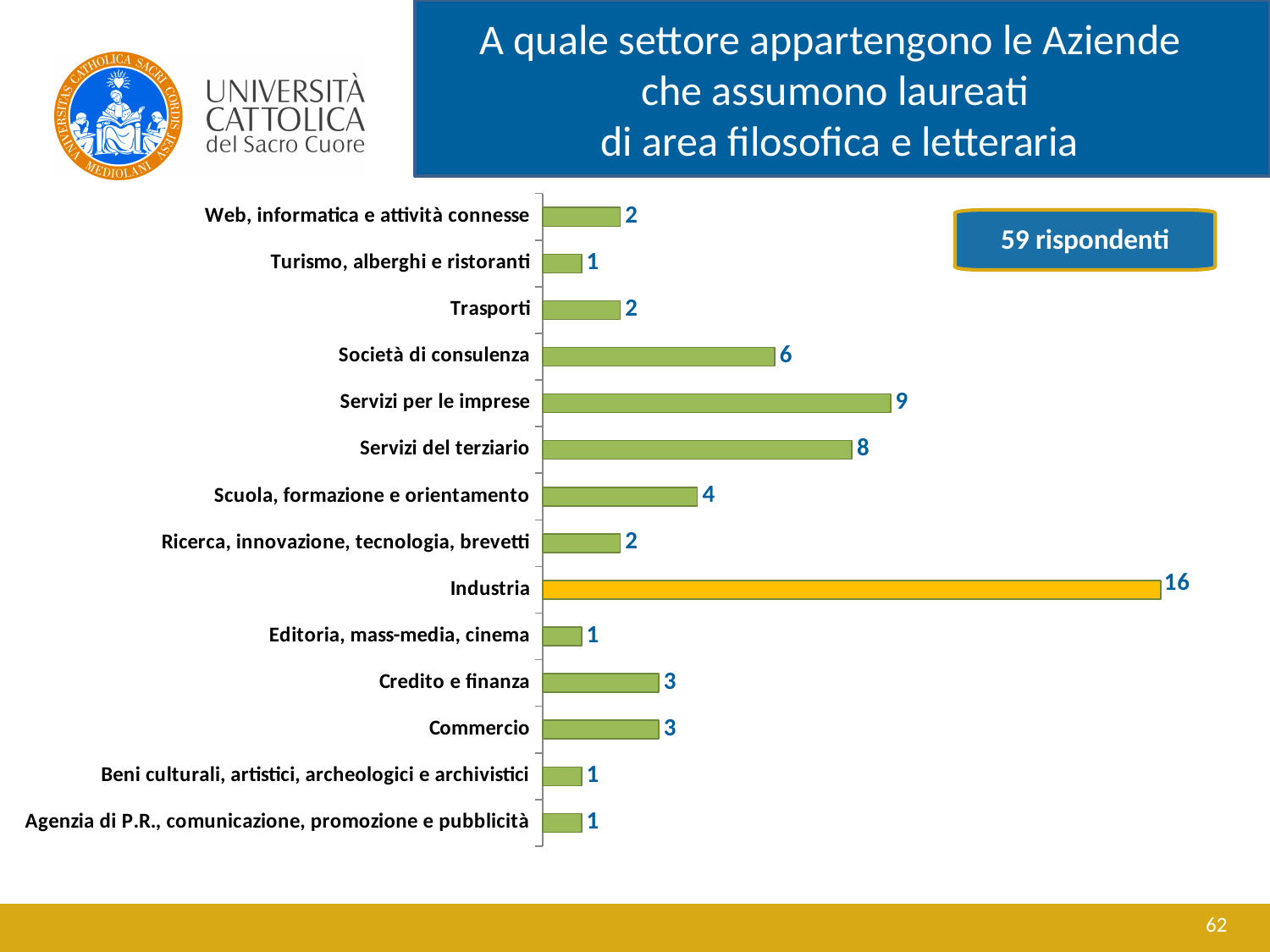
What kind of chart is shown on the slide? Bar chart Which is larger, the value for Società di consulenza or the value for Credito e finanza? Società di consulenza What is the difference between the values for Servizi per le imprese and Società di consulenza? 3 What is the difference between the values for Industria and Servizi del terziario? 8 How many categories are shown in the chart? 14 How many respondents does the slide report? 59 rispondenti Which bar is coloured differently from the others? Industria What is the value for Scuola, formazione e orientamento? 4 Which category has the highest value? Industria What is the value for Commercio? 3 What is the value for Servizi per le imprese? 9 What is the value for Industria? 16